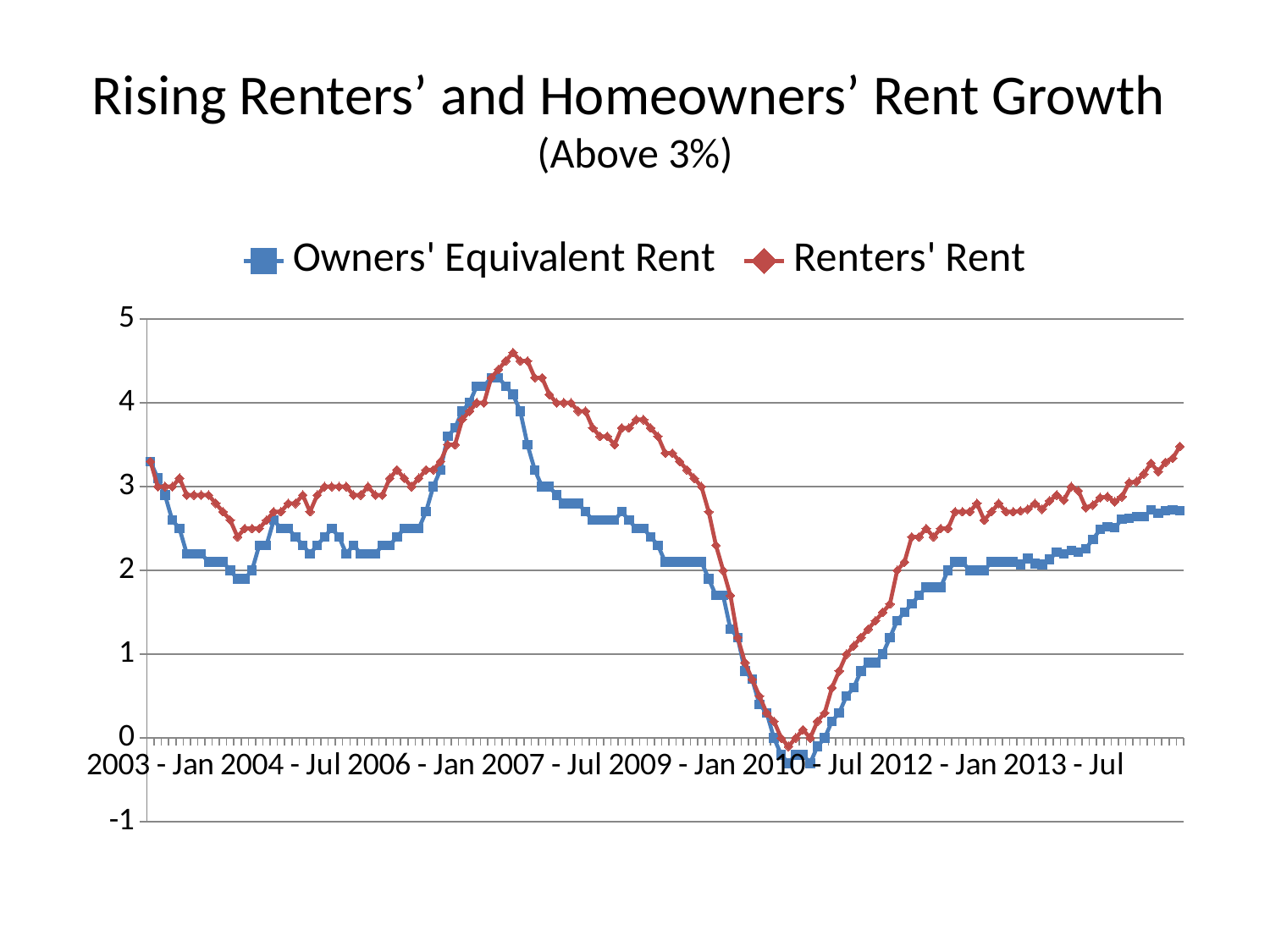
Which series is drawn with red diamond markers? Renters' Rent Which series reaches the highest peak on the chart? Renters' Rent How many series does the legend list? 2 Is the value for Renters' Rent at 2007 - Jul greater or less than 4? greater Is the value for Owners' Equivalent Rent at 2013 - Jul greater or less than 3? less What kind of chart is shown on the slide? Line chart What is the title of the chart on the slide? Rising Renters' and Homeowners' Rent Growth (Above 3%) Does Renters' Rent rise or fall between 2007 - Jul and 2010 - Jul? Fall Is the value for Owners' Equivalent Rent at 2009 - Jan greater or less than 3? less At 2009 - Jan, which series has the higher value, Owners' Equivalent Rent or Renters' Rent? Renters' Rent